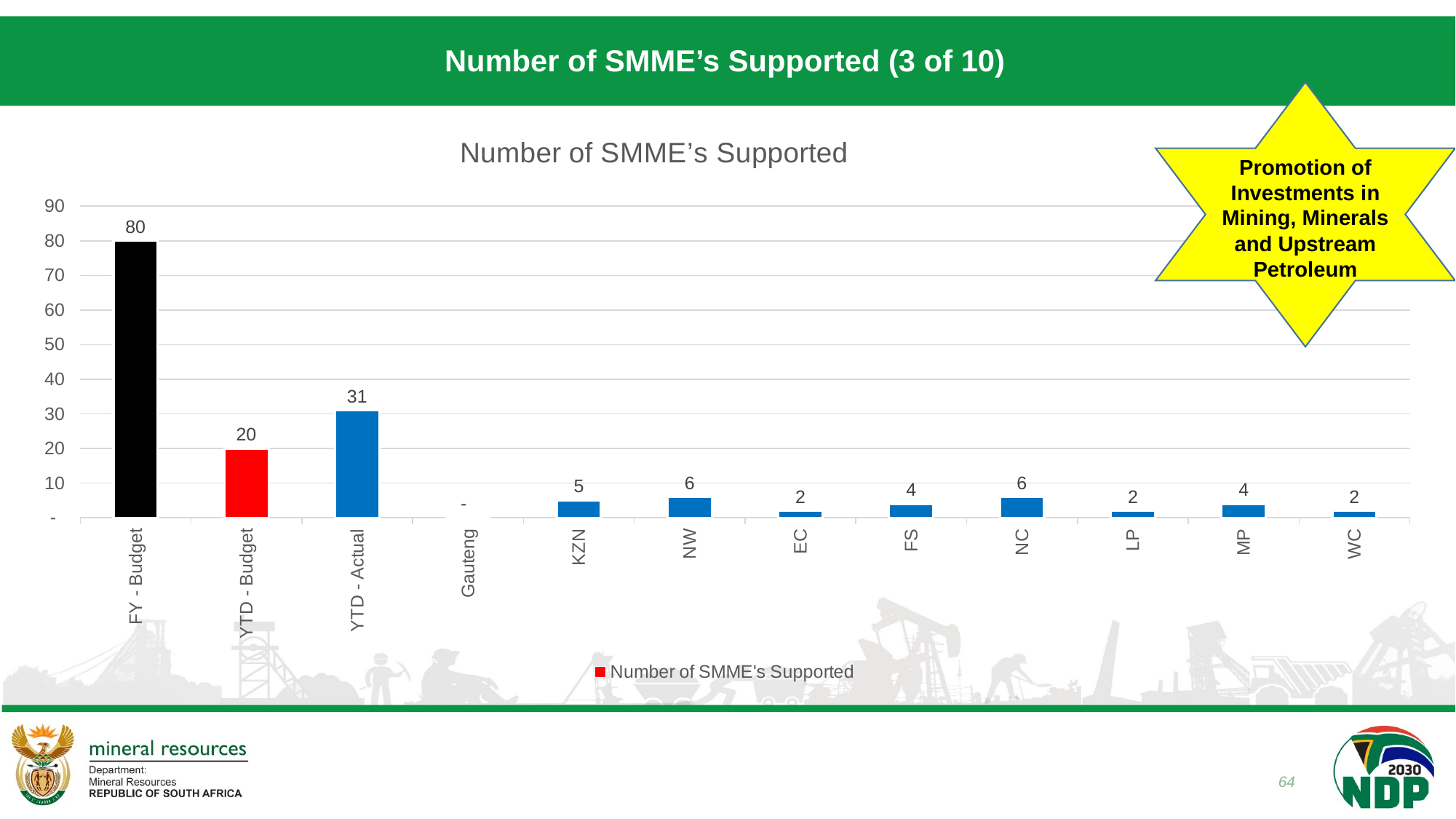
What is the value for YTD - Actual? 31 What is the title of the chart? Number of SMME's Supported What is the value for KZN? 5 Which category has the highest value? FY - Budget What kind of chart is this? Bar chart What is the value for NC? 6 Which is larger, the value for NW or the value for FS? NW How many categories are shown on the x axis? 12 What is the value for FY - Budget? 80 What is the difference between FY - Budget and YTD - Actual? 49 What is the difference between YTD - Actual and YTD - Budget? 11 What colour is the FY - Budget bar? Black